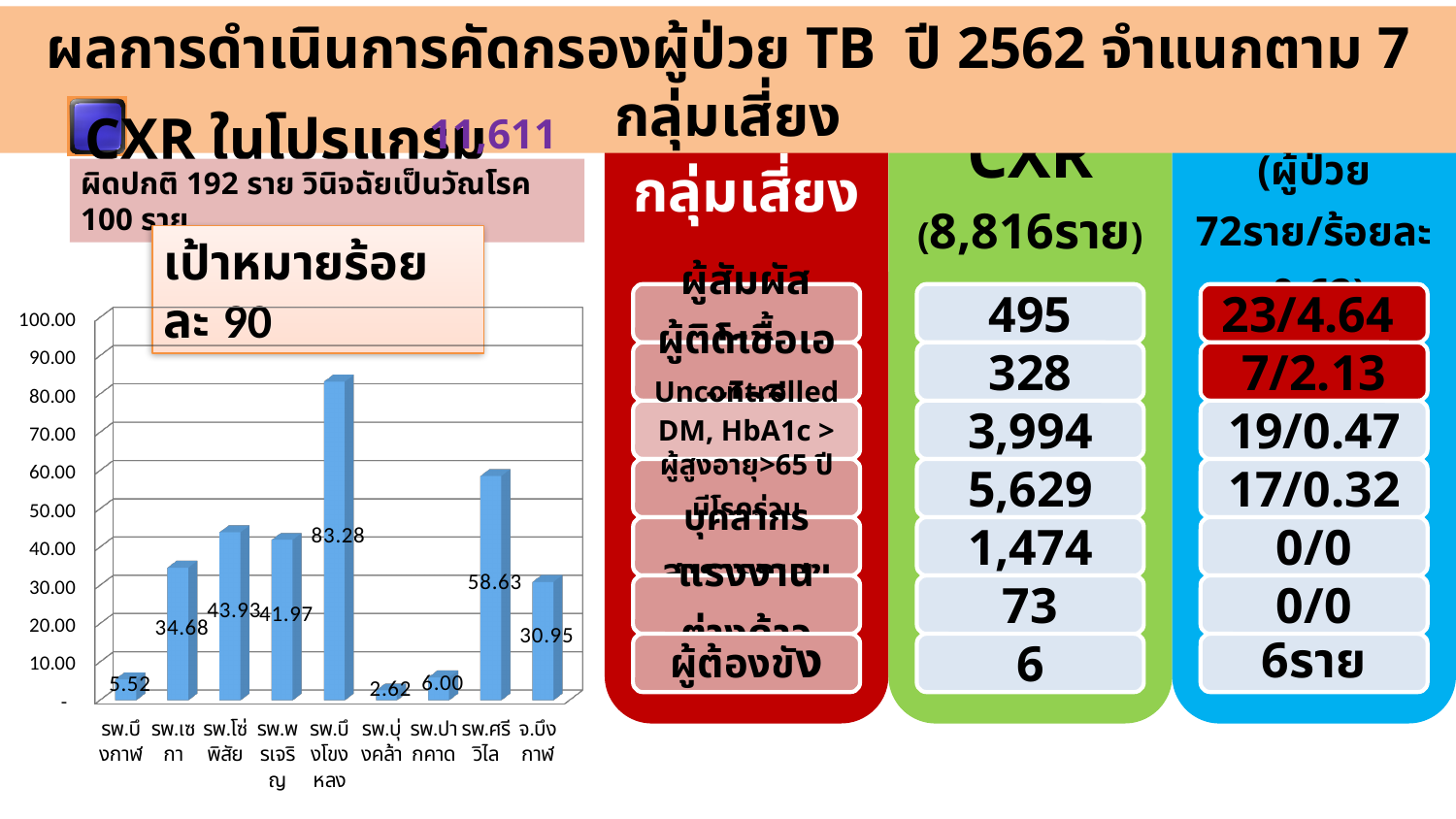
How many categories are shown on the x axis of the bar chart? 9 Which category has the lowest value in the bar chart? รพ.บุ่งคล้า What kind of chart is shown on the left of the slide? bar chart What is the value for รพ.ศรีวิไล in the bar chart? 58.63 Which is larger in the bar chart, the value for รพ.เซกา or the value for รพ.ปากคาด? รพ.เซกา What is the value for รพ.บุ่งคล้า in the bar chart? 2.62 Which category has the highest value in the bar chart? รพ.บึงโขงหลง What is the value for รพ.บึงโขงหลง in the bar chart? 83.28 What is the difference between the values for รพ.บึงโขงหลง and รพ.ศรีวิไล? 24.65 What is the value for จ.บึงกาฬ in the bar chart? 30.95 Is the value for รพ.โซ่พิสัย greater or less than 40.00? greater What target percentage is stated in the box above the bar chart? ร้อยละ 90